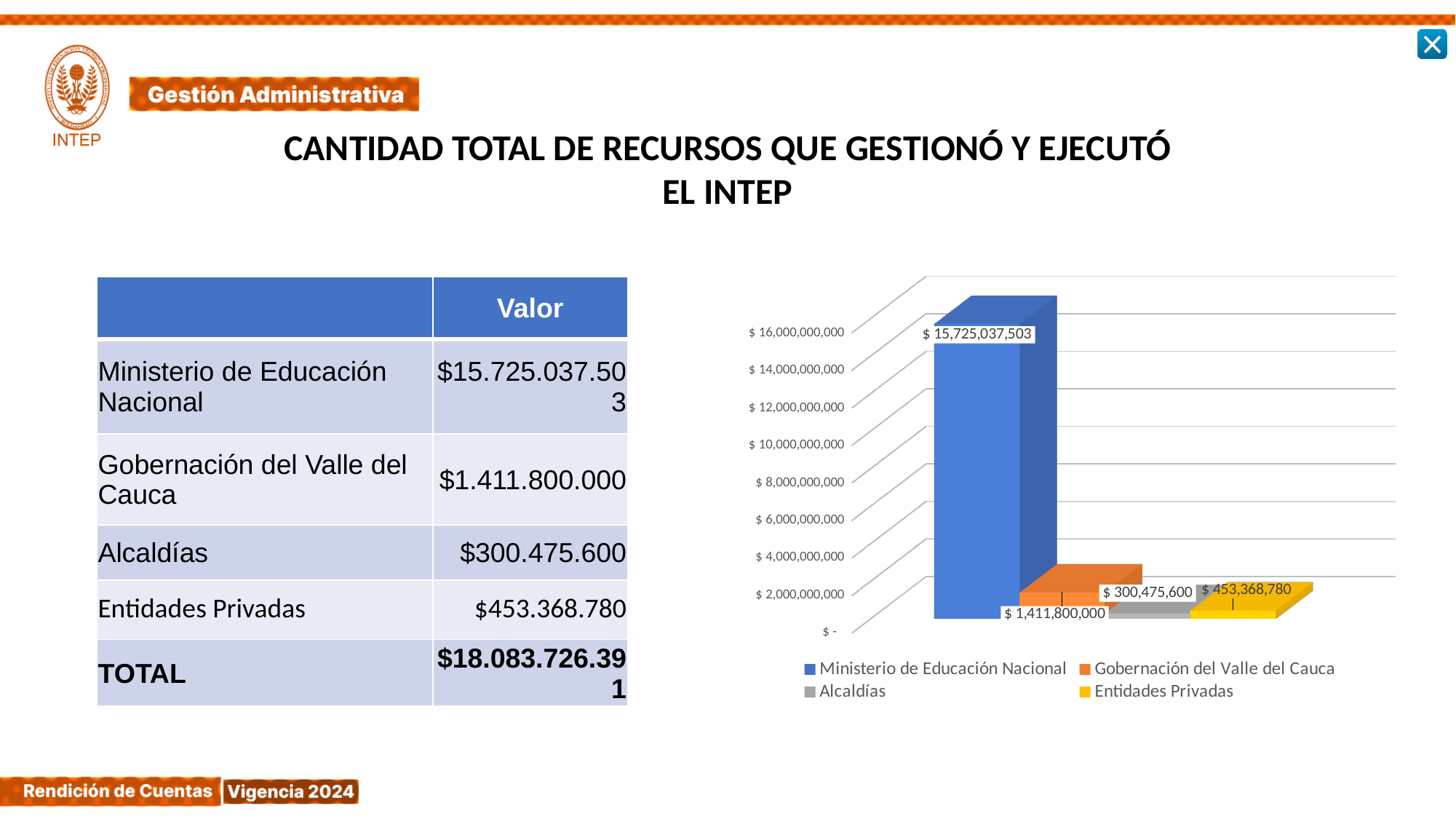
What is the difference between the values for Ministerio de Educación Nacional and Gobernación del Valle del Cauca in the chart? $ 14,313,237,503 What is the value shown for Ministerio de Educación Nacional in the chart? $ 15,725,037,503 What is the value shown for Entidades Privadas in the chart? $ 453,368,780 What is the value shown for Gobernación del Valle del Cauca in the chart? $ 1,411,800,000 Which is larger in the chart, Entidades Privadas or Alcaldías? Entidades Privadas How many series does the chart legend list? 4 What kind of chart is shown on the slide? bar chart Which series has the highest value in the chart? Ministerio de Educación Nacional What is the value shown for Alcaldías in the chart? $ 300,475,600 How many bars are plotted in the chart? 4 Which series has the lowest value in the chart? Alcaldías Is the value for Ministerio de Educación Nacional greater or less than $ 14,000,000,000? greater